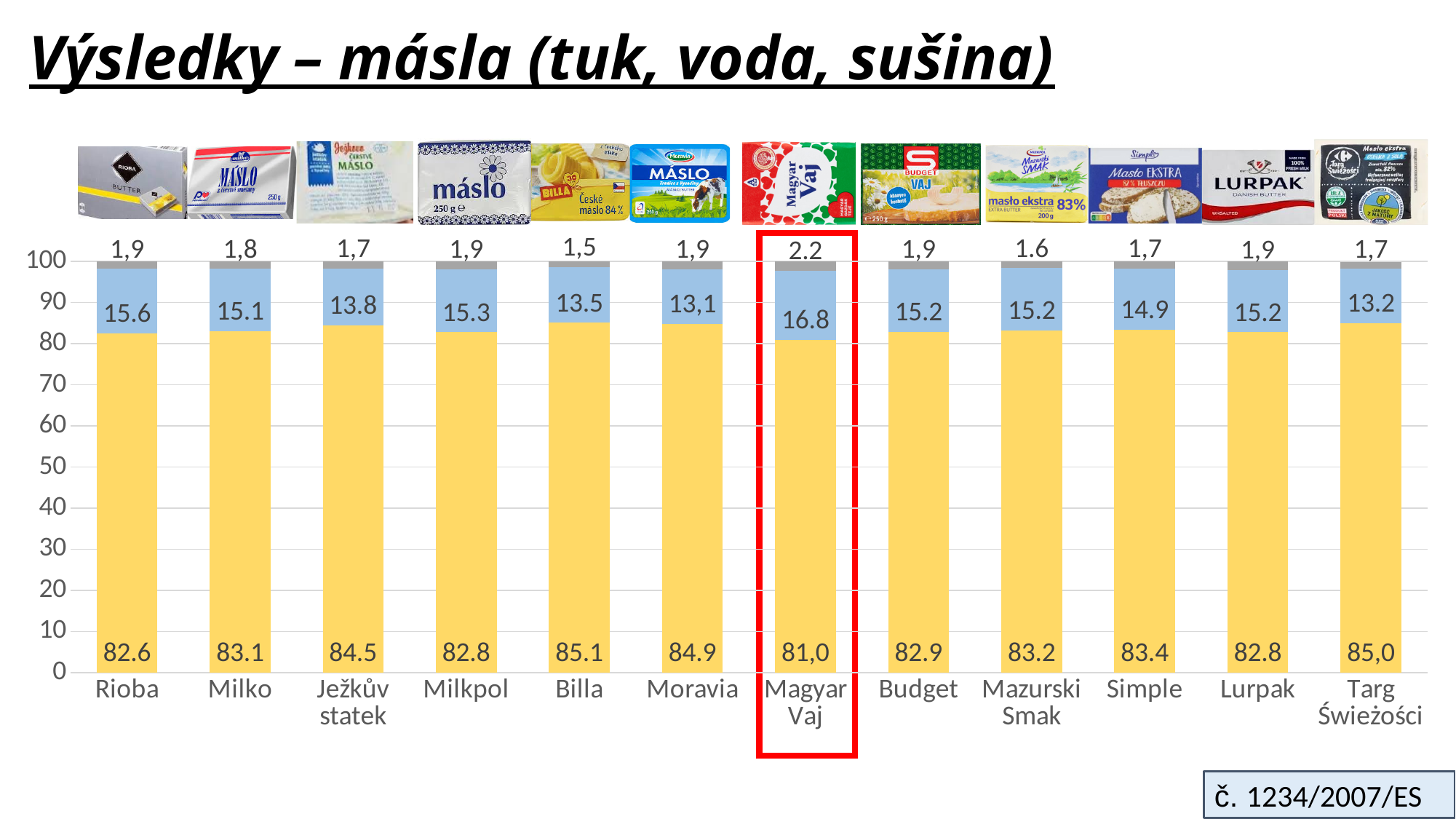
Which product has the lowest value in the yellow (bottom) segment? Magyar Vaj What is the value printed on the yellow (bottom) segment of the bar for Targ Świeżości? 85,0 Which product has the lowest value in the blue (middle) segment? Moravia What is the difference between the yellow segment values for Billa and Magyar Vaj? 4.1 Which has the larger yellow (bottom) segment value, Ježkův statek or Milkpol? Ježkův statek What is the value printed on the yellow (bottom) segment of the bar for Billa? 85.1 What kind of chart is shown on the slide? Stacked bar chart What is the value printed above the bar for Mazurski Smak (top grey segment)? 1.6 Which product's bar is highlighted with a red box on the slide? Magyar Vaj Which product has the highest value in the blue (middle) segment? Magyar Vaj How many products (categories) are shown on the x axis of the chart? 12 What is the value printed on the blue (middle) segment of the bar for Magyar Vaj? 16.8